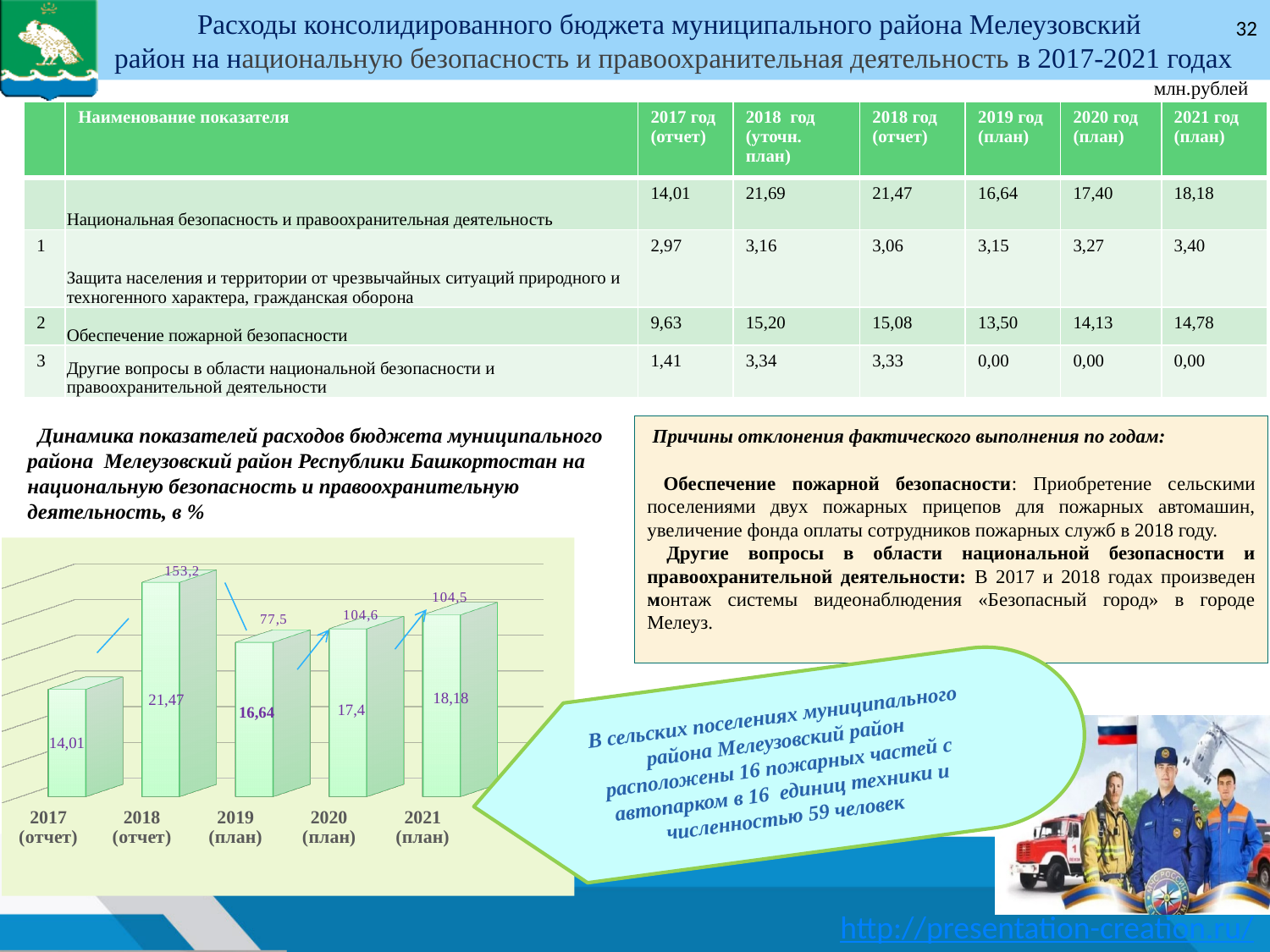
What is the value of the bar for 2018 (отчет)? 21,47 What is the value of the bar for 2019 (план)? 16,64 Which year has the highest bar on the chart? 2018 (отчет) What kind of chart is shown on the slide? bar chart What growth percentage is shown above the 2018 (отчет) bar? 153,2 How many year categories are plotted on the bar chart? 5 What is the value of the bar for 2020 (план)? 17,4 Which is larger, the bar for 2019 (план) or the bar for 2021 (план)? 2021 (план) What is the value of the bar for 2021 (план)? 18,18 Which year has the lowest bar on the chart? 2017 (отчет) What is the difference between the bar values for 2018 (отчет) and 2017 (отчет)? 7,46 What is the value of the bar for 2017 (отчет)? 14,01